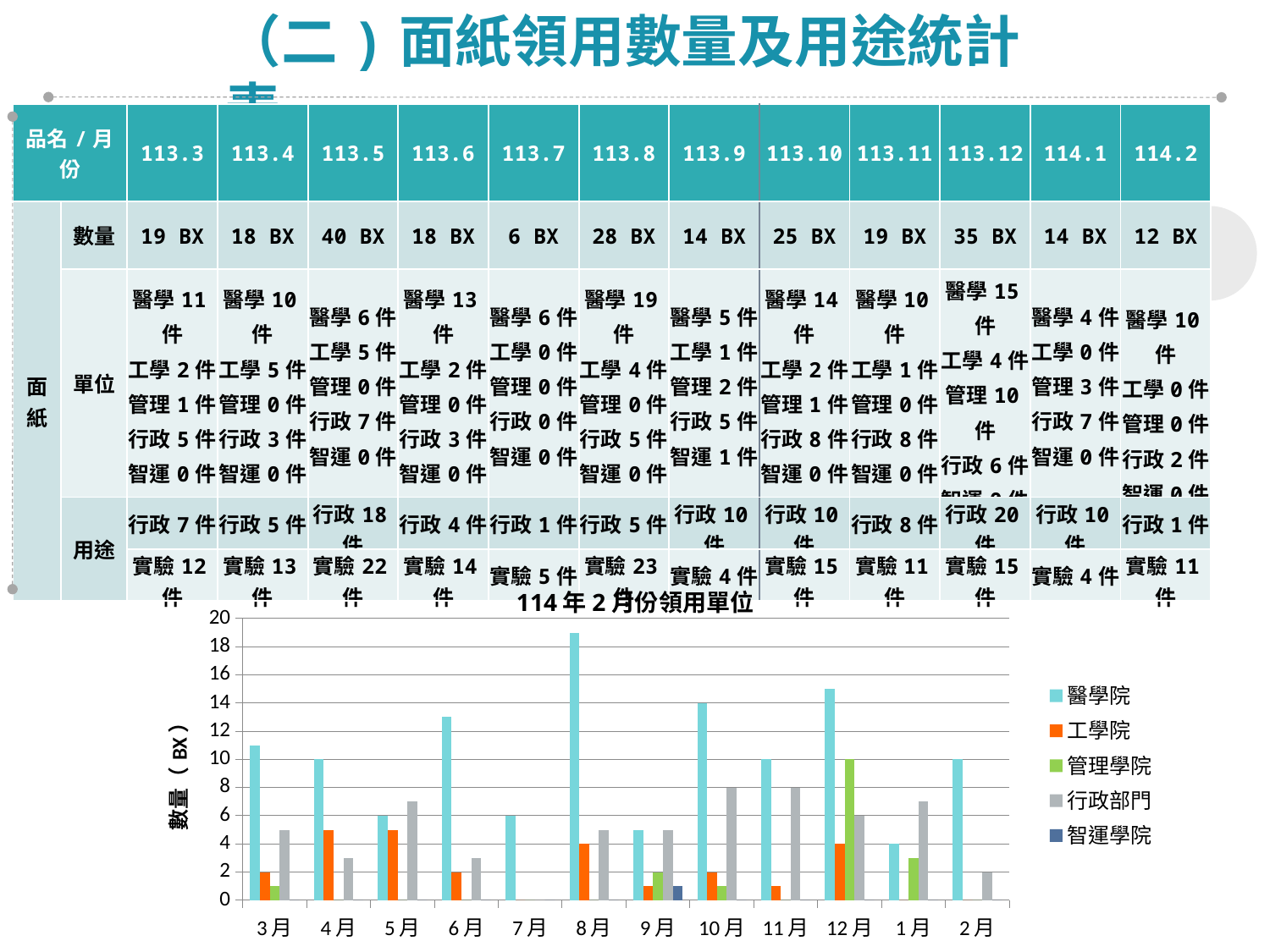
How many series does the legend of the bar chart list? 5 In the bar chart, what is the value of 醫學院 in 4月? 10 What is the label on the y axis of the bar chart? 數量（BX） In the bar chart, which month has the tallest 醫學院 bar? 8月 What kind of chart is shown at the bottom of the slide? bar chart How many months are shown along the x axis of the bar chart? 12 In the bar chart, which series has the tallest bar in 10月? 醫學院 In the bar chart, which is larger in 3月: 醫學院 or 行政部門? 醫學院 In the bar chart, what is the value of 管理學院 in 12月? 10 In the bar chart, what is the value of 行政部門 in 10月? 8 In the bar chart, is the value for 醫學院 in 8月 greater or less than 18? greater In the bar chart, what is the value of 工學院 in 8月? 4